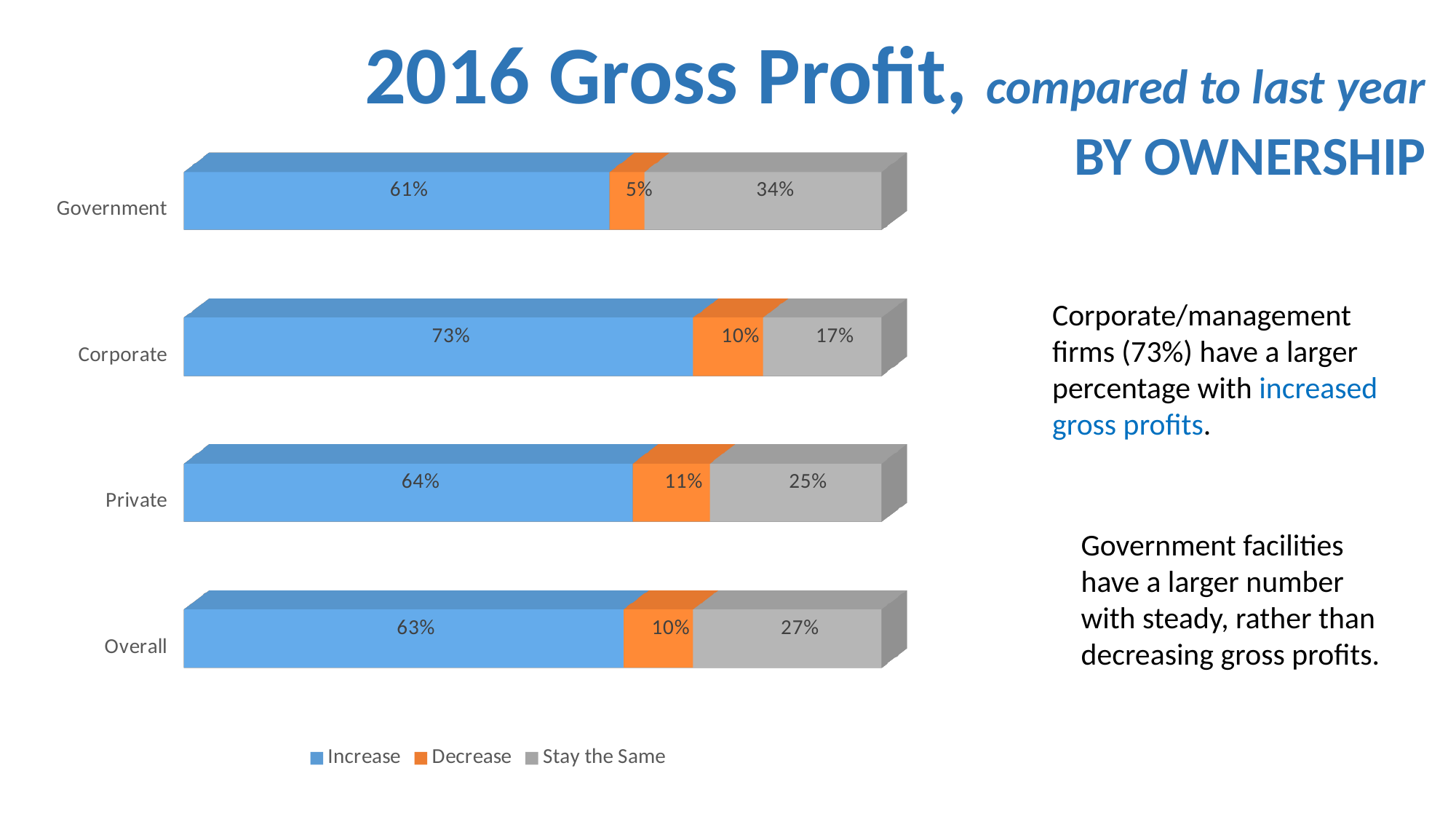
Which ownership category has the highest 'Increase' percentage? Corporate What percentage of Government facilities reported an increase in gross profit? 61% Which ownership category has the lowest 'Decrease' percentage? Government What type of chart is shown on the slide? Stacked bar chart What percentage of Corporate firms reported a decrease in gross profit? 10% What is the Overall 'Increase' value? 63% What is the difference between the Corporate and Government 'Increase' percentages? 12% Which category has the highest 'Stay the Same' percentage? Government How many ownership categories are shown in the chart? 4 Which is larger: the 'Stay the Same' value for Government or for Corporate? Government How many series does the legend list? 3 What is the 'Stay the Same' value for Private? 25%